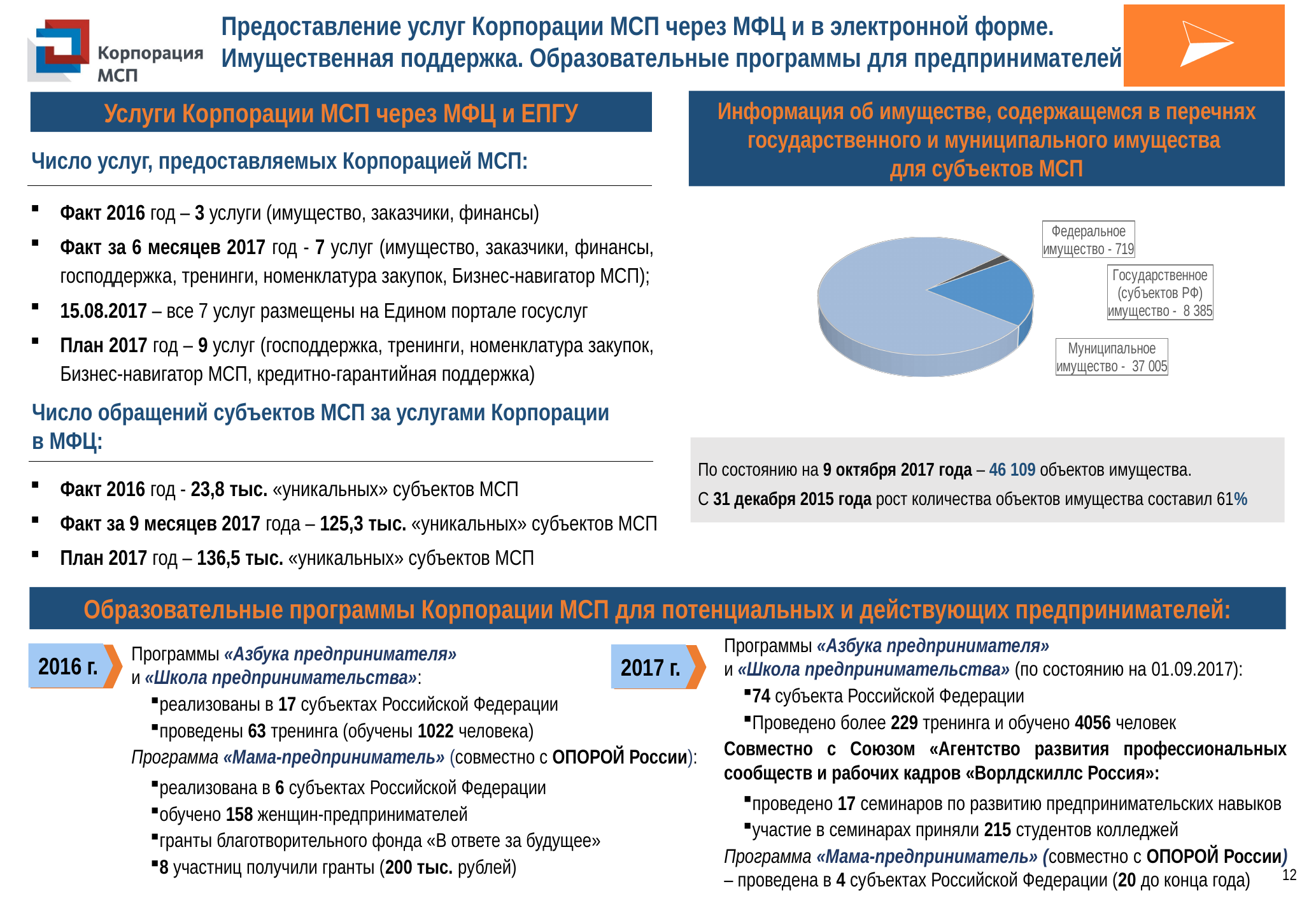
What is the value for Федеральное имущество in the pie chart? 719 What is the difference between Муниципальное имущество and Государственное (субъектов РФ) имущество in the pie chart? 28 620 How many slices does the pie chart have? 3 What is the total of all three slices in the pie chart? 46 109 Which is larger in the pie chart: Государственное (субъектов РФ) имущество or Федеральное имущество? Государственное (субъектов РФ) имущество What is the title of the section containing the pie chart? Информация об имуществе, содержащемся в перечнях государственного и муниципального имущества для субъектов МСП What is the value for Государственное (субъектов РФ) имущество in the pie chart? 8 385 Which category has the smallest slice in the pie chart? Федеральное имущество What kind of chart is shown on the slide? Pie chart What is the value for Муниципальное имущество in the pie chart? 37 005 What is the difference between Государственное (субъектов РФ) имущество and Федеральное имущество in the pie chart? 7 666 Which category has the largest slice in the pie chart? Муниципальное имущество